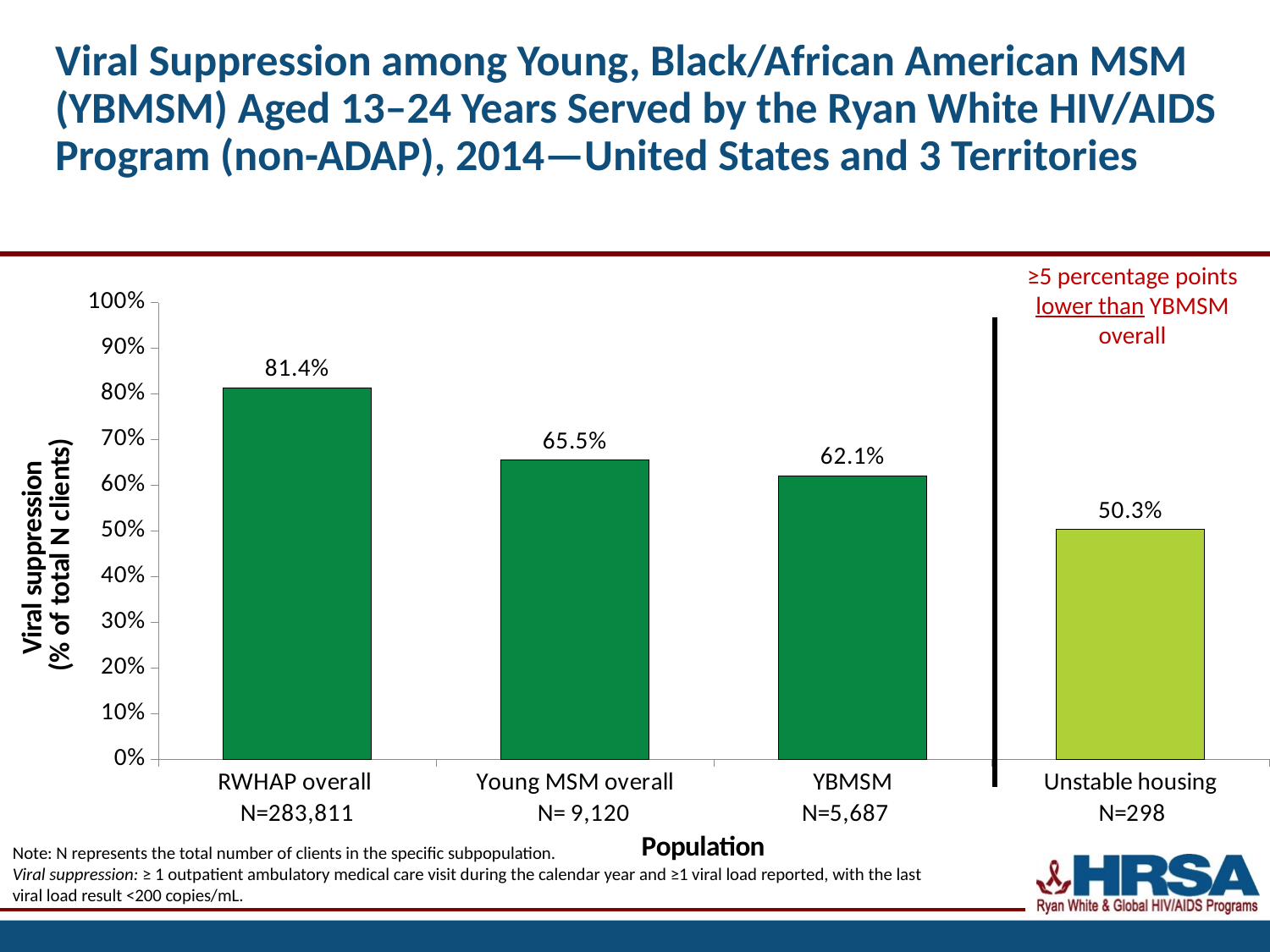
What is the viral suppression percentage for the Unstable housing group? 50.3% Which population has the highest viral suppression percentage? RWHAP overall What is the N (number of clients) shown for the YBMSM category? N=5,687 What is the viral suppression percentage for RWHAP overall? 81.4% What type of chart is shown on the slide? Bar chart Which has a higher viral suppression percentage, Young MSM overall or YBMSM? Young MSM overall Which population has the lowest viral suppression percentage? Unstable housing How many population categories are shown in the chart? 4 What is the difference in viral suppression between YBMSM and the Unstable housing group, in percentage points? 11.8 percentage points What is the difference in viral suppression between RWHAP overall and YBMSM, in percentage points? 19.3 percentage points What is the viral suppression percentage for Young MSM overall? 65.5% What is the viral suppression percentage for YBMSM? 62.1%